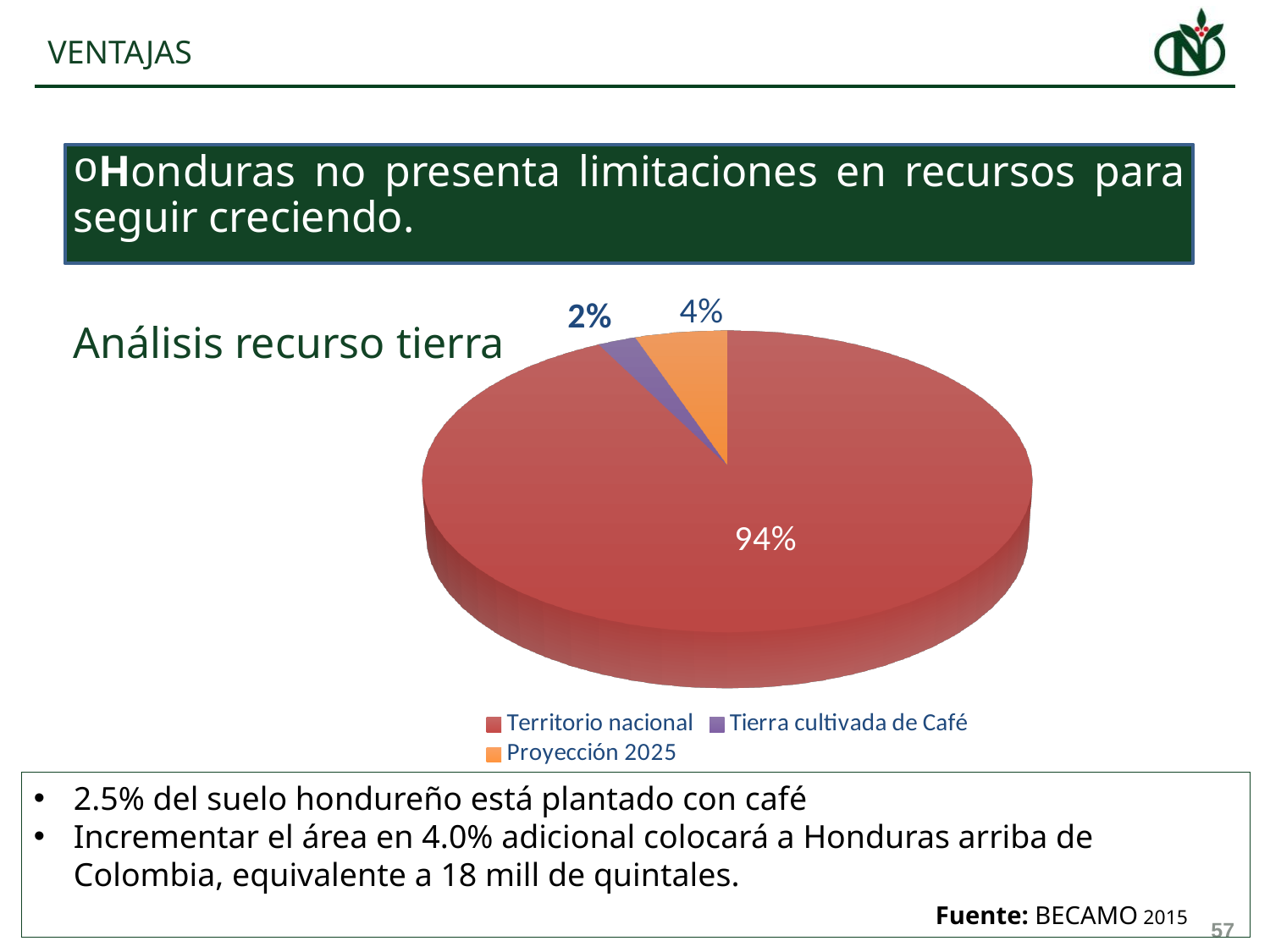
What share of the pie does Territorio nacional represent? 94% What share of the pie does Tierra cultivada de Café represent? 2% What share of the pie does Proyección 2025 represent? 4% Which slice of the pie is the smallest? Tierra cultivada de Café What kind of chart is shown on the slide? Pie chart Which is larger, Proyección 2025 or Tierra cultivada de Café? Proyección 2025 How many entries does the legend list? 3 How many slices does the pie chart have? 3 Which slice of the pie is the largest? Territorio nacional What colour is the Proyección 2025 slice? Orange What is the title shown next to the pie chart? Análisis recurso tierra What is the difference in percentage points between Proyección 2025 and Tierra cultivada de Café? 2